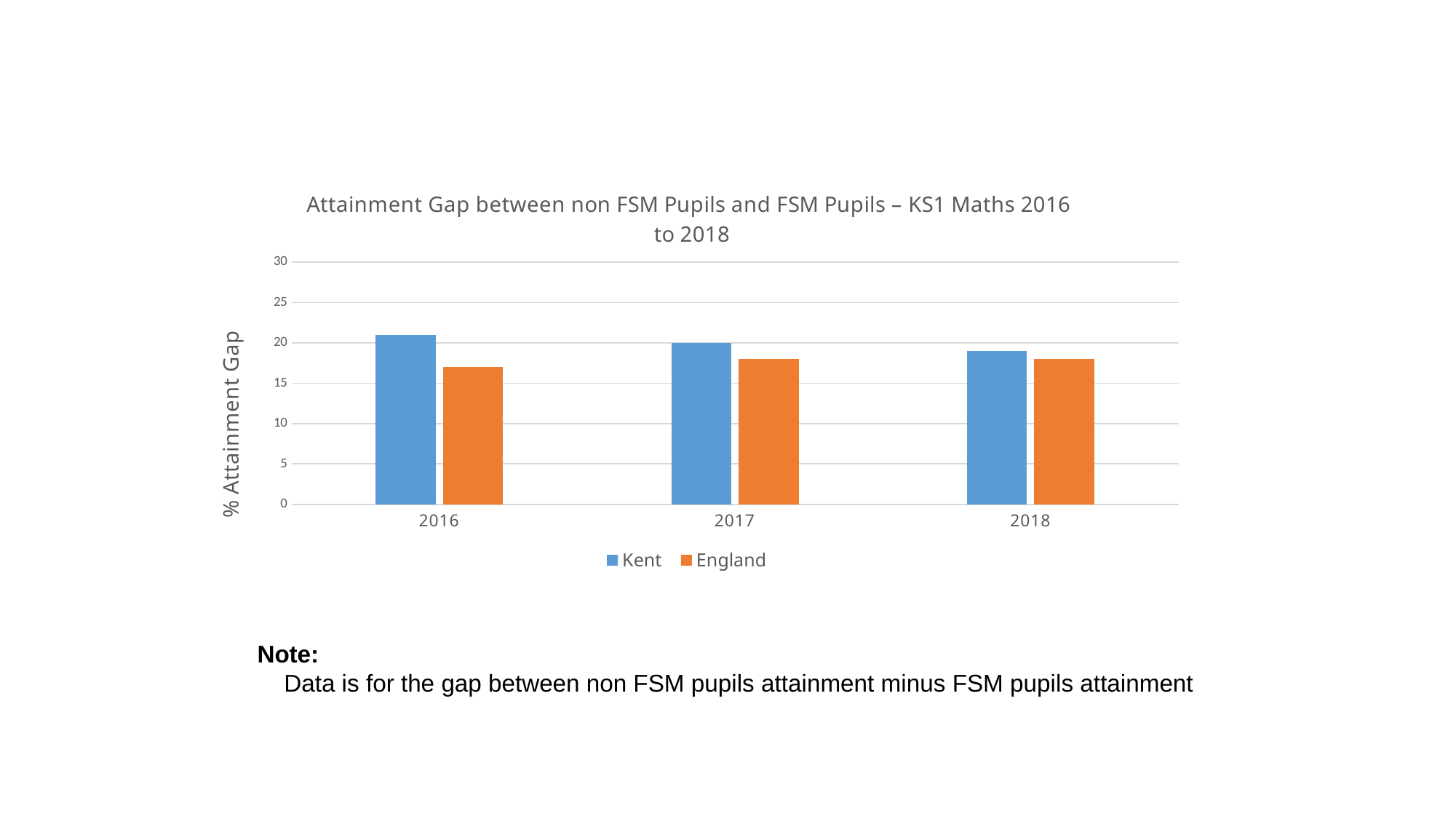
What kind of chart is shown on the slide? Bar chart In which year is the England value lowest? 2016 Is the value for Kent in 2016 greater or less than 20? greater Do the Kent values rise or fall from 2016 to 2018? fall Which series is shown in blue? Kent In 2016, which is larger, the Kent value or the England value? Kent In which year is the Kent value highest? 2016 In 2017, which is larger, the Kent value or the England value? Kent How many years are shown on the x axis? 3 Is the value for England in 2016 greater or less than 20? less How many series does the legend list? 2 What is the label on the vertical axis? % Attainment Gap